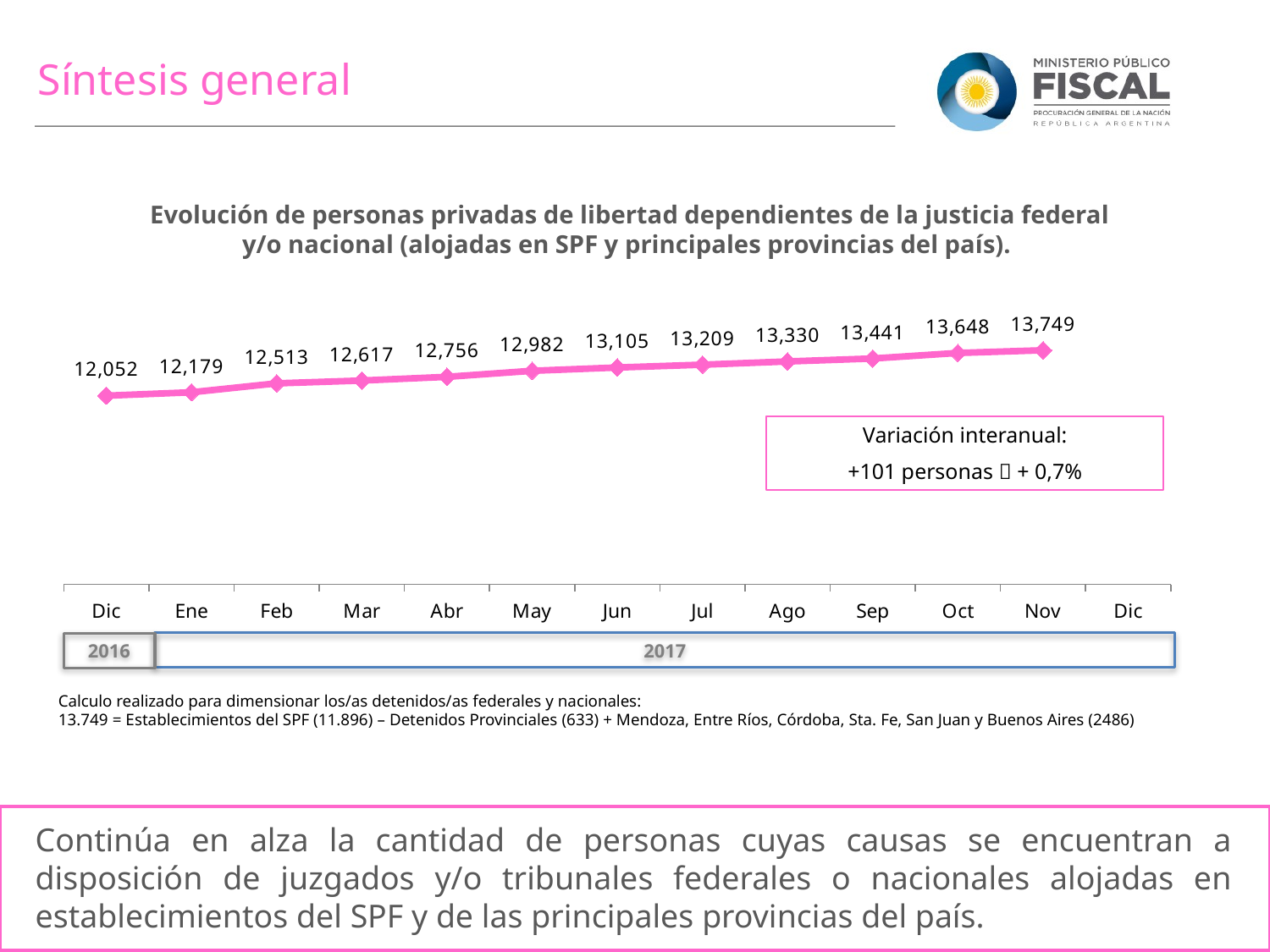
What is the difference between the values for Feb and Ene 2017? 334 What is the value for Nov 2017 on the chart? 13,749 How many data points are plotted with labels on the line? 12 What kind of chart is shown on the slide? Line chart What is the value for Ago 2017? 13,330 What is the value for Dic 2016 on the chart? 12,052 Which month has the lowest value on the chart? Dic (2016) What is the difference between the value for Nov 2017 and the value for Dic 2016? 1,697 Which month has the highest value on the chart? Nov (2017) Do the values rise or fall from Dic 2016 to Nov 2017? Rise What is the value for May 2017? 12,982 Which is larger, the value for Jun or the value for Jul? Jul